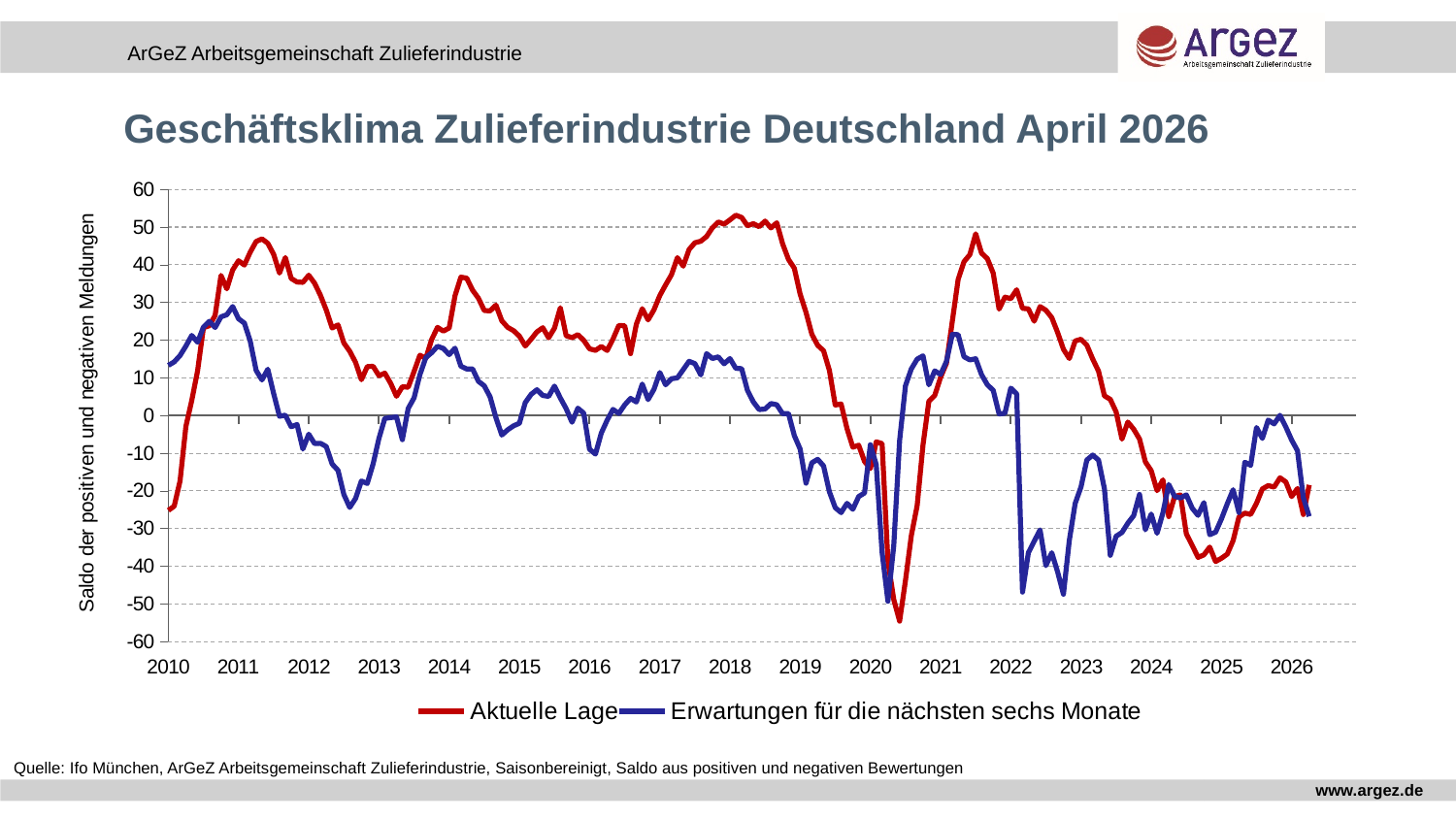
What kind of chart is shown on the slide? Line chart Is the peak value of Aktuelle Lage in 2018 greater or less than 40? greater Which series reaches the highest value anywhere on the chart? Aktuelle Lage At the start of 2010, which series has the higher value, Aktuelle Lage or Erwartungen für die nächsten sechs Monate? Erwartungen für die nächsten sechs Monate Is the lowest value of Aktuelle Lage in 2020 greater or less than -40? less At the start of 2018, which series has the higher value, Aktuelle Lage or Erwartungen für die nächsten sechs Monate? Aktuelle Lage Which series is drawn in red? Aktuelle Lage How many series does the legend list? 2 Does Aktuelle Lage rise or fall between the start of 2018 and the start of 2020? Fall How many year labels are shown on the x axis? 17 What is the title of the chart? Geschäftsklima Zulieferindustrie Deutschland April 2026 Is the lowest value of Erwartungen für die nächsten sechs Monate in 2022 greater or less than -30? less